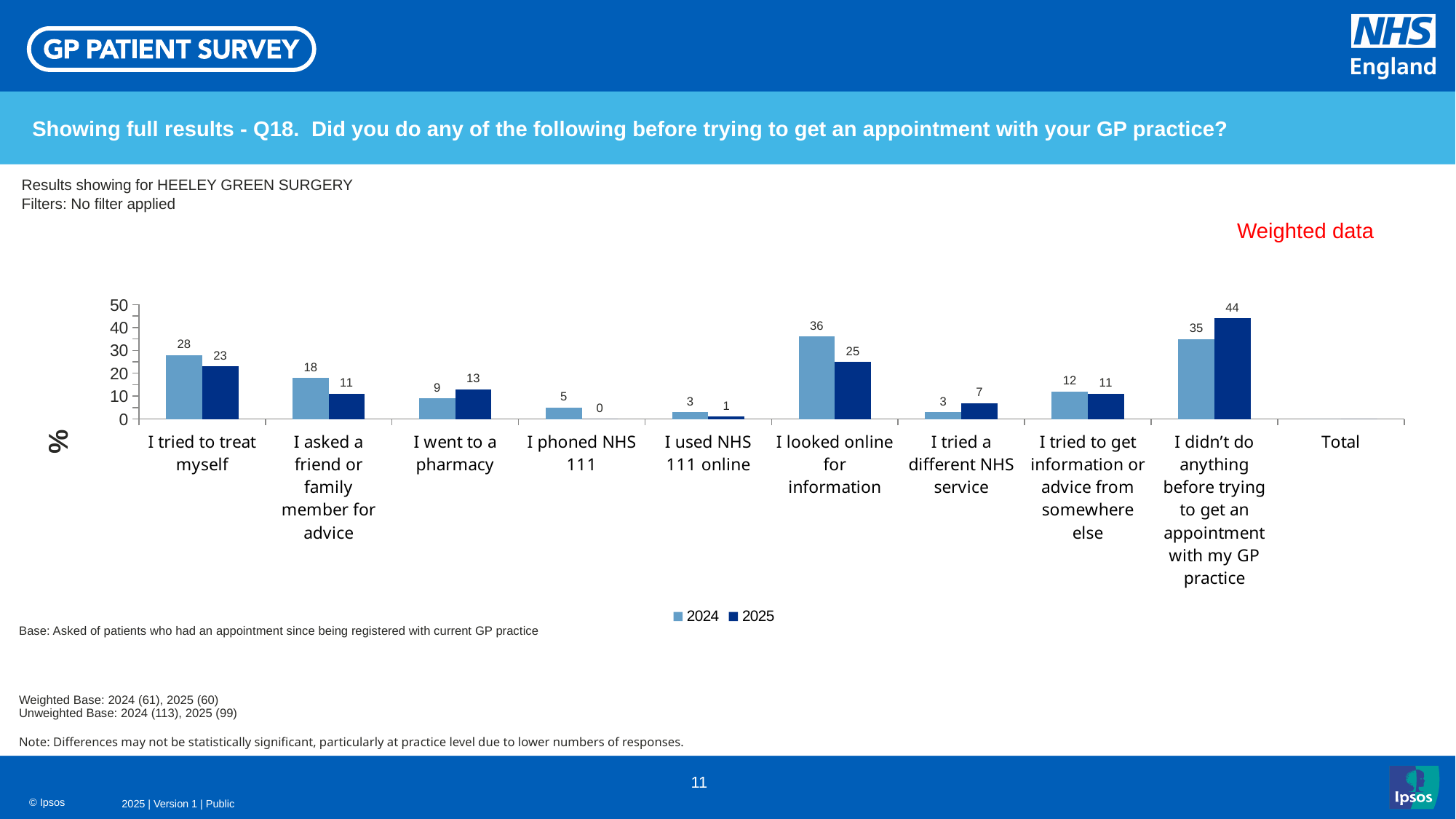
What kind of chart is shown on the slide? Bar chart Which is larger for "I went to a pharmacy": the 2024 value or the 2025 value? 2025 What is the 2024 value for "I looked online for information"? 36 What is the 2025 value for "I didn't do anything before trying to get an appointment with my GP practice"? 44 Is the 2025 value for "I tried to treat myself" greater or less than 30? less Which category has the highest 2025 value? I didn't do anything before trying to get an appointment with my GP practice What is the 2025 value for "I phoned NHS 111"? 0 Which category has the lowest 2025 value? I phoned NHS 111 What is the difference between the 2024 and 2025 values for "I looked online for information"? 11 Which year does the darker blue series represent? 2025 How many series does the legend list? 2 Which category has the highest 2024 value? I looked online for information